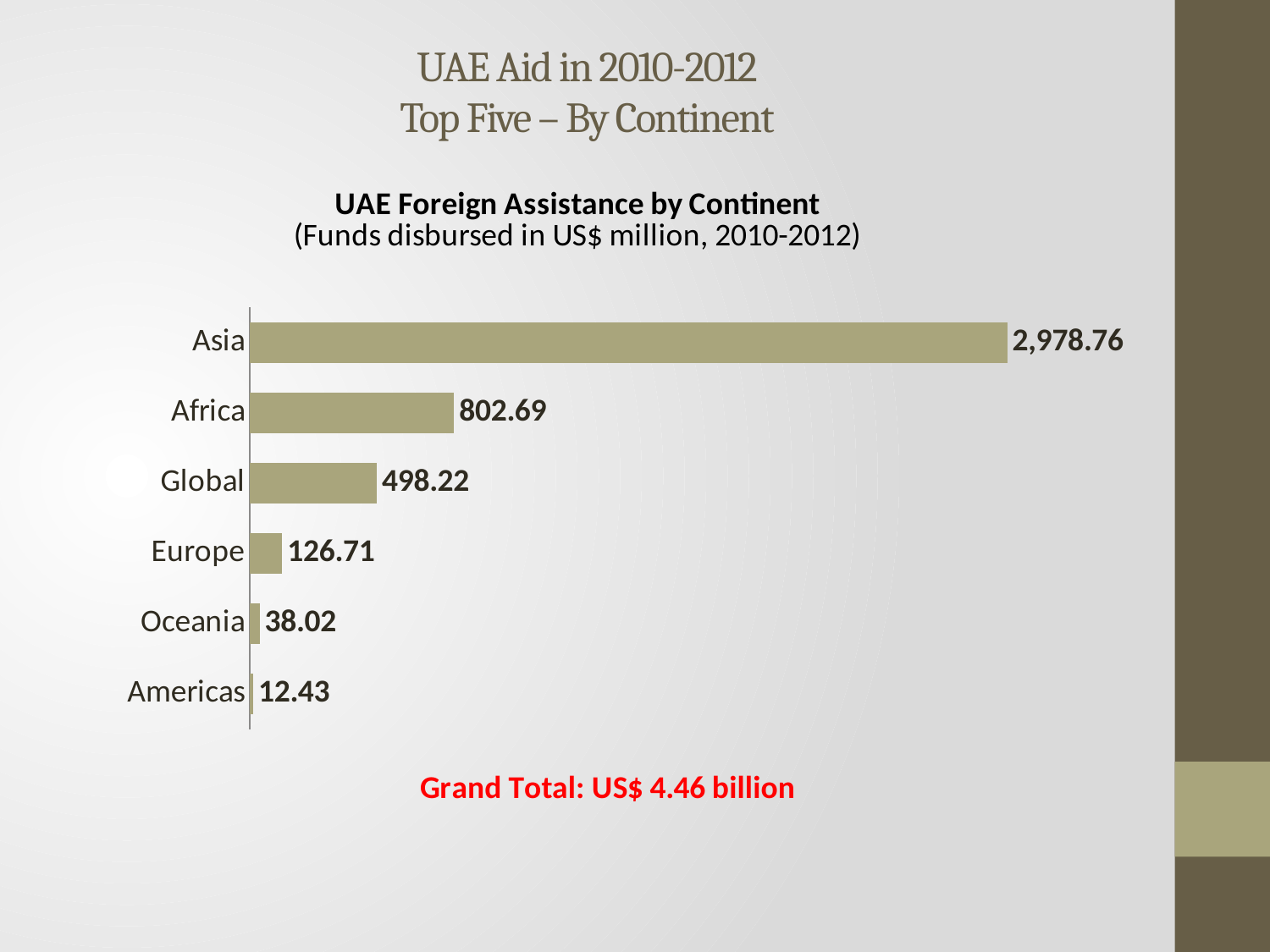
What is the title of the chart? UAE Foreign Assistance by Continent What is the value for Americas? 12.43 Which category has the lowest value? Americas Which is larger, the value for Global or the value for Europe? Global Which category has the highest value? Asia What kind of chart is shown on the slide? Bar chart What is the difference between the values for Europe and Oceania? 88.69 How many categories are shown in the chart? 6 What is the value for Africa? 802.69 What is the value for Europe? 126.71 What is the difference between the values for Africa and Global? 304.47 What is the value for Asia? 2,978.76